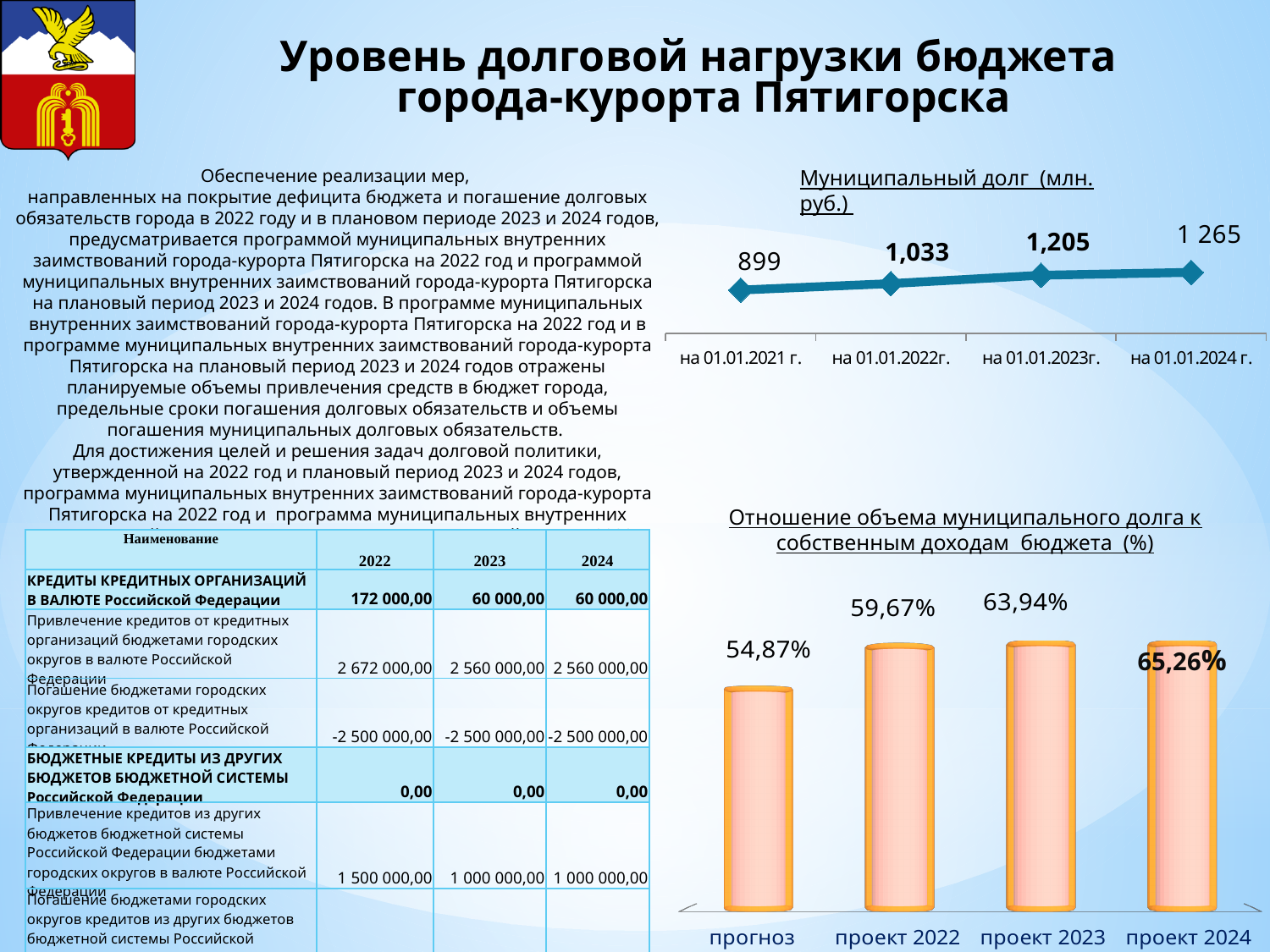
What kind of chart is 'Муниципальный долг (млн. руб.)'? line chart In the chart 'Муниципальный долг (млн. руб.)', how many data points are plotted? 4 What kind of chart is 'Отношение объема муниципального долга к собственным доходам бюджета (%)'? bar chart In the chart 'Муниципальный долг (млн. руб.)', do the values rise or fall from 01.01.2021 to 01.01.2024? rise In the chart 'Муниципальный долг (млн. руб.)', what is the value on 01.01.2021? 899 In the chart 'Отношение объема муниципального долга к собственным доходам бюджета (%)', what is the value for прогноз? 54,87% In the chart 'Отношение объема муниципального долга к собственным доходам бюджета (%)', what is the value for проект 2022? 59,67% In the chart 'Муниципальный долг (млн. руб.)', what is the value on 01.01.2024? 1 265 In the chart 'Отношение объема муниципального долга к собственным доходам бюджета (%)', which category has the highest value? проект 2024 In the chart 'Отношение объема муниципального долга к собственным доходам бюджета (%)', what is the difference between проект 2024 and прогноз? 10,39% In the chart 'Отношение объема муниципального долга к собственным доходам бюджета (%)', which is larger: проект 2023 or проект 2022? проект 2023 In the chart 'Муниципальный долг (млн. руб.)', which date has the lowest value? на 01.01.2021 г.